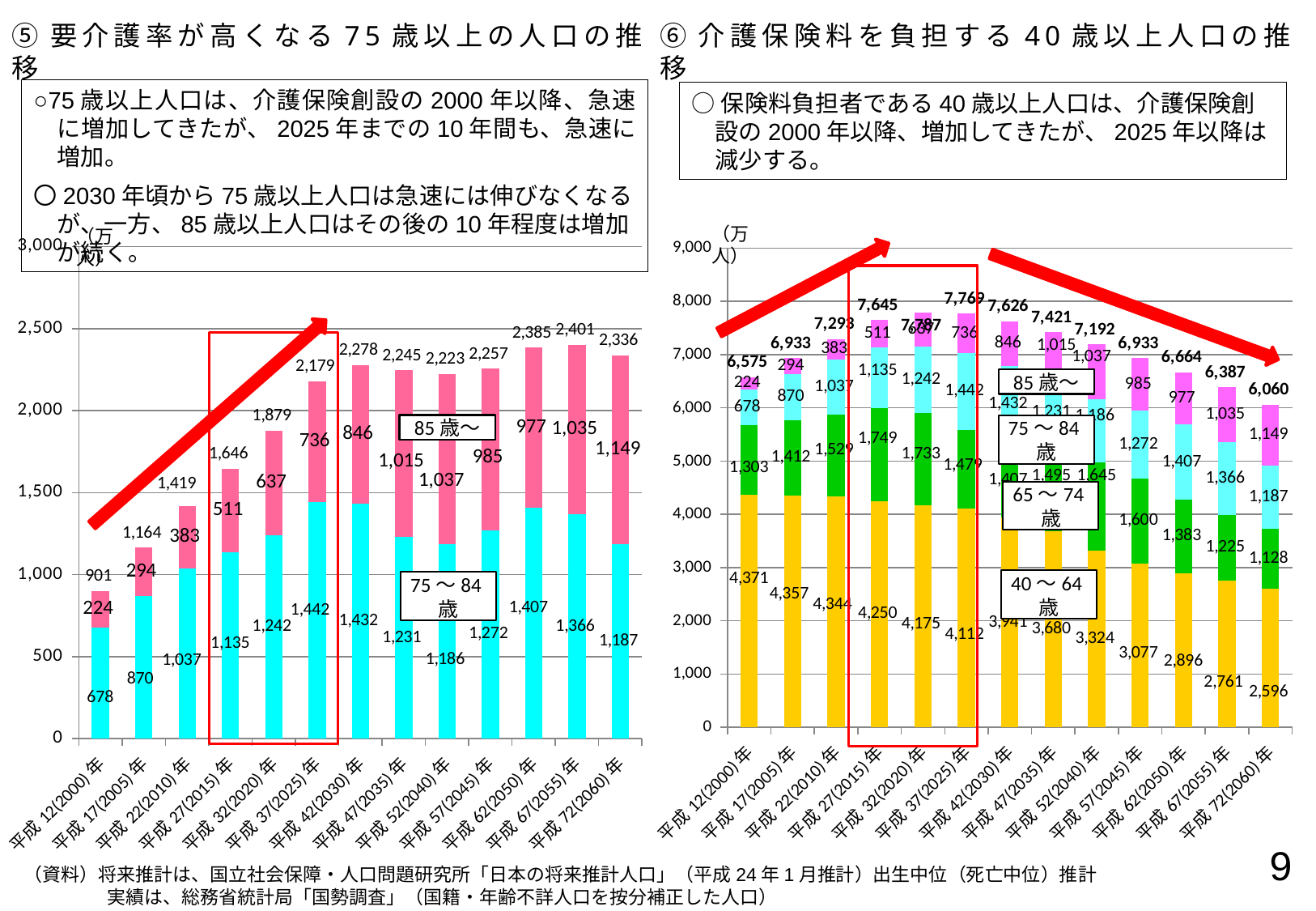
In the right chart (⑥ 40歳以上人口の推移), which year has the lowest total? 平成72(2060)年 In the right chart (⑥ 40歳以上人口の推移), which year has the highest total? 平成32(2020)年 In the left chart (⑤ 75歳以上の人口の推移), which year has the highest total? 平成67(2055)年 In the left chart (⑤ 75歳以上の人口の推移), what is the difference between the 75～84歳 value and the 85歳～ value for 平成12(2000)年? 454 In the left chart (⑤ 75歳以上の人口の推移), how many years are shown on the x axis? 13 In the left chart (⑤ 75歳以上の人口の推移), which year has the lowest total? 平成12(2000)年 In the left chart (⑤ 75歳以上の人口の推移), what is the value of the 85歳～ segment for 平成72(2060)年? 1,149 What type of chart is the right chart (⑥ 40歳以上人口の推移)? Stacked bar chart In the right chart (⑥ 40歳以上人口の推移), what is the difference between the totals for 平成12(2000)年 and 平成72(2060)年? 515 In the right chart (⑥ 40歳以上人口の推移), what is the 40～64歳 value for 平成12(2000)年? 4,371 In the right chart (⑥ 40歳以上人口の推移), how many age-group segments make up each stacked bar? 4 In the left chart (⑤ 75歳以上の人口の推移), what is the total population shown for 平成37(2025)年? 2,179